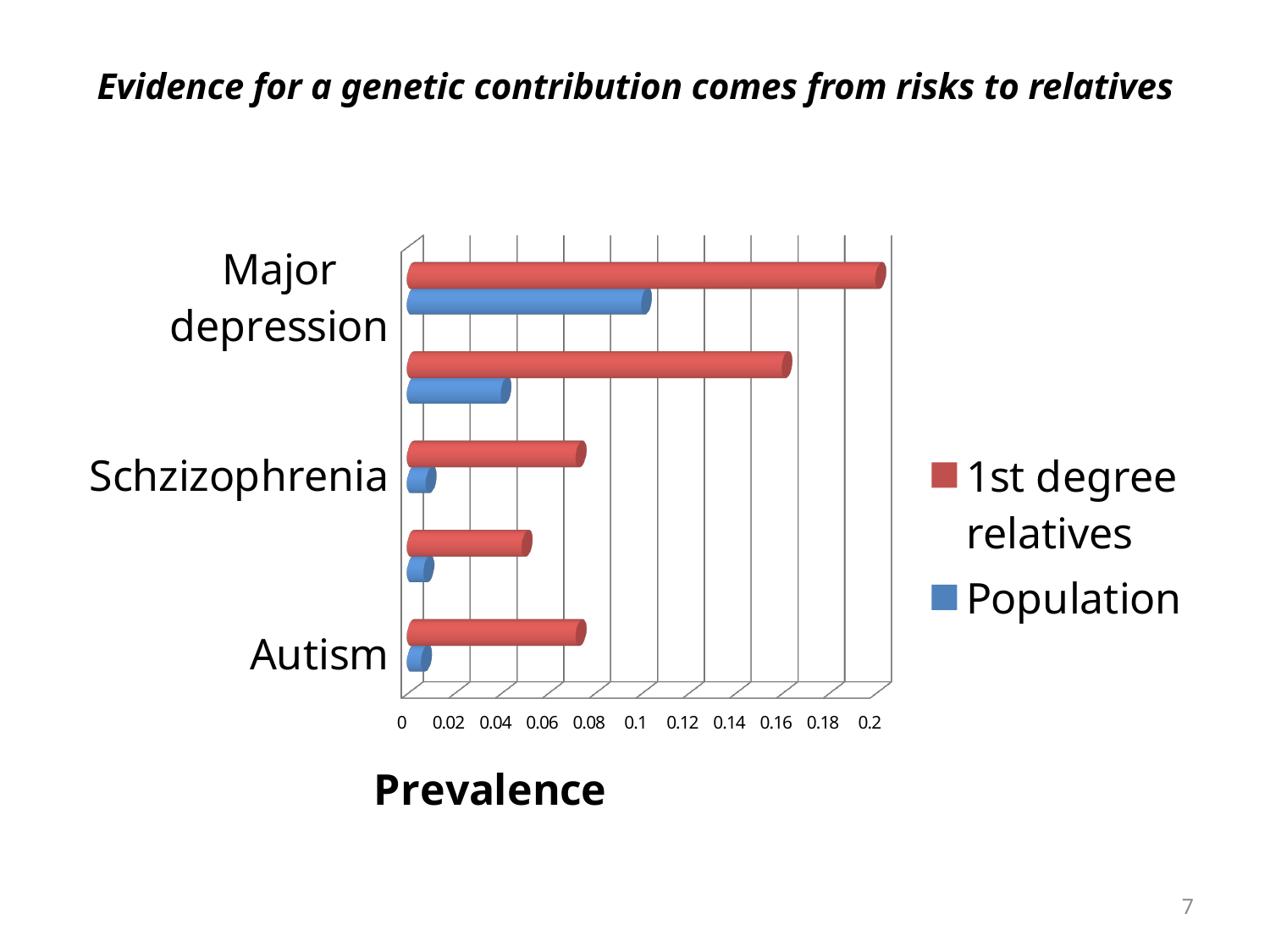
Is the Population value for Autism greater or less than 0.02? less For Major depression, which is larger: the 1st degree relatives value or the Population value? 1st degree relatives Is the 1st degree relatives value for Schizophrenia greater or less than 0.1? less What is the title of the horizontal axis? Prevalence What are the two series named in the legend? 1st degree relatives and Population Among the labeled disorders, which has the highest 1st degree relatives prevalence? Major depression What kind of chart is shown on the slide? Bar chart Is the Population value for Major depression greater or less than 0.08? greater How many series does the legend list? 2 Which has the larger 1st degree relatives value: Major depression or Schizophrenia? Major depression